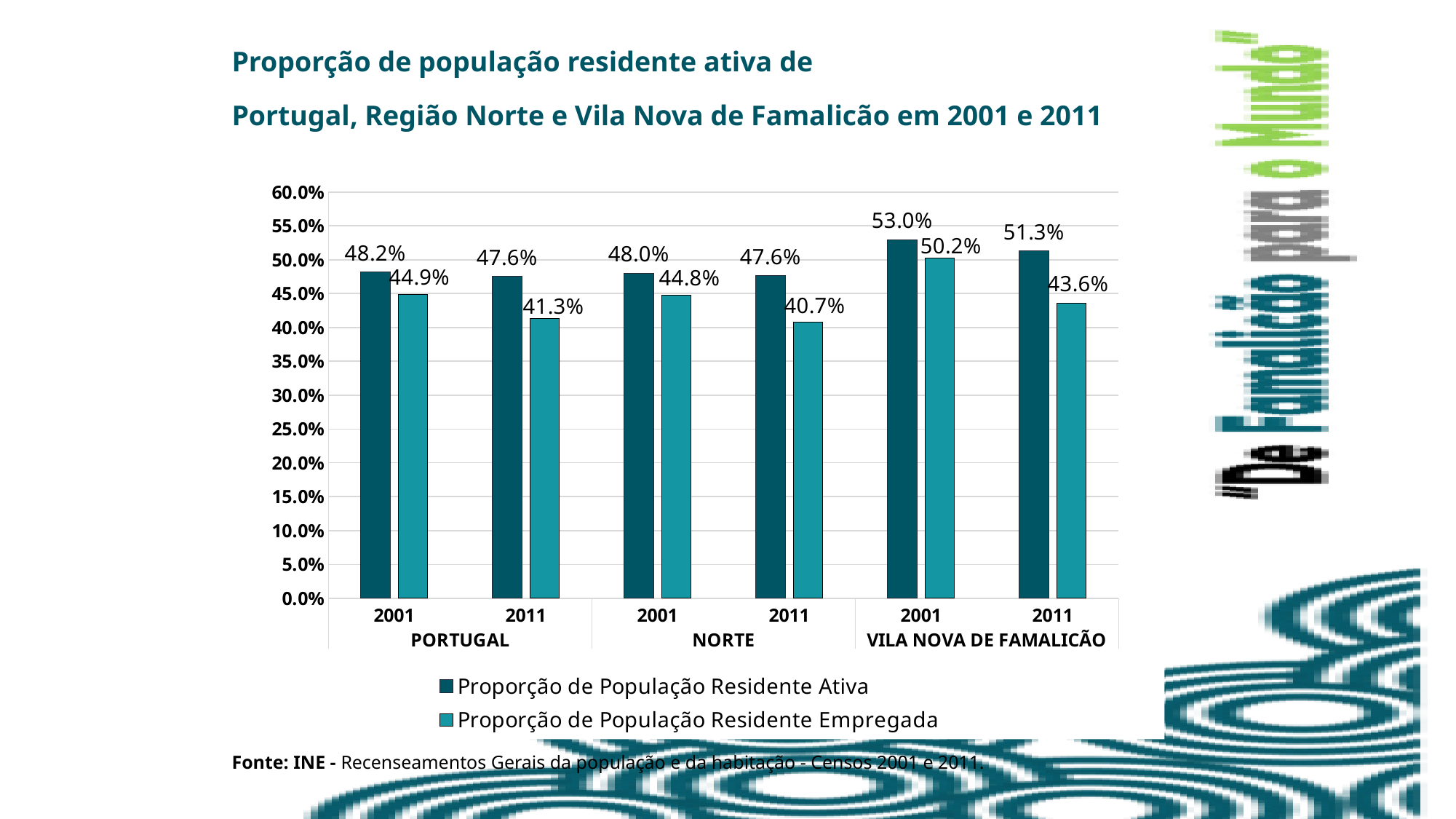
What is the Proporção de População Residente Ativa for Portugal in 2001? 48.2% Which region and year has the lowest Proporção de População Residente Empregada? Norte, 2011 By how much did the Proporção de População Residente Empregada for Portugal fall from 2001 to 2011? 3.6% How many series does the legend list? 2 How many regions are shown on the x axis? 3 What is the Proporção de População Residente Ativa for Vila Nova de Famalicão in 2011? 51.3% What is the Proporção de População Residente Empregada for Norte in 2011? 40.7% What is the difference between the Proporção de População Residente Ativa and the Proporção de População Residente Empregada for Vila Nova de Famalicão in 2011? 7.7% Which is larger: the Proporção de População Residente Empregada for Vila Nova de Famalicão in 2001 or for Norte in 2001? Vila Nova de Famalicão in 2001 Which region and year has the highest Proporção de População Residente Ativa? Vila Nova de Famalicão, 2001 Is the Proporção de População Residente Empregada for Portugal in 2011 greater or less than 45.0%? less What kind of chart is shown on the slide? Bar chart